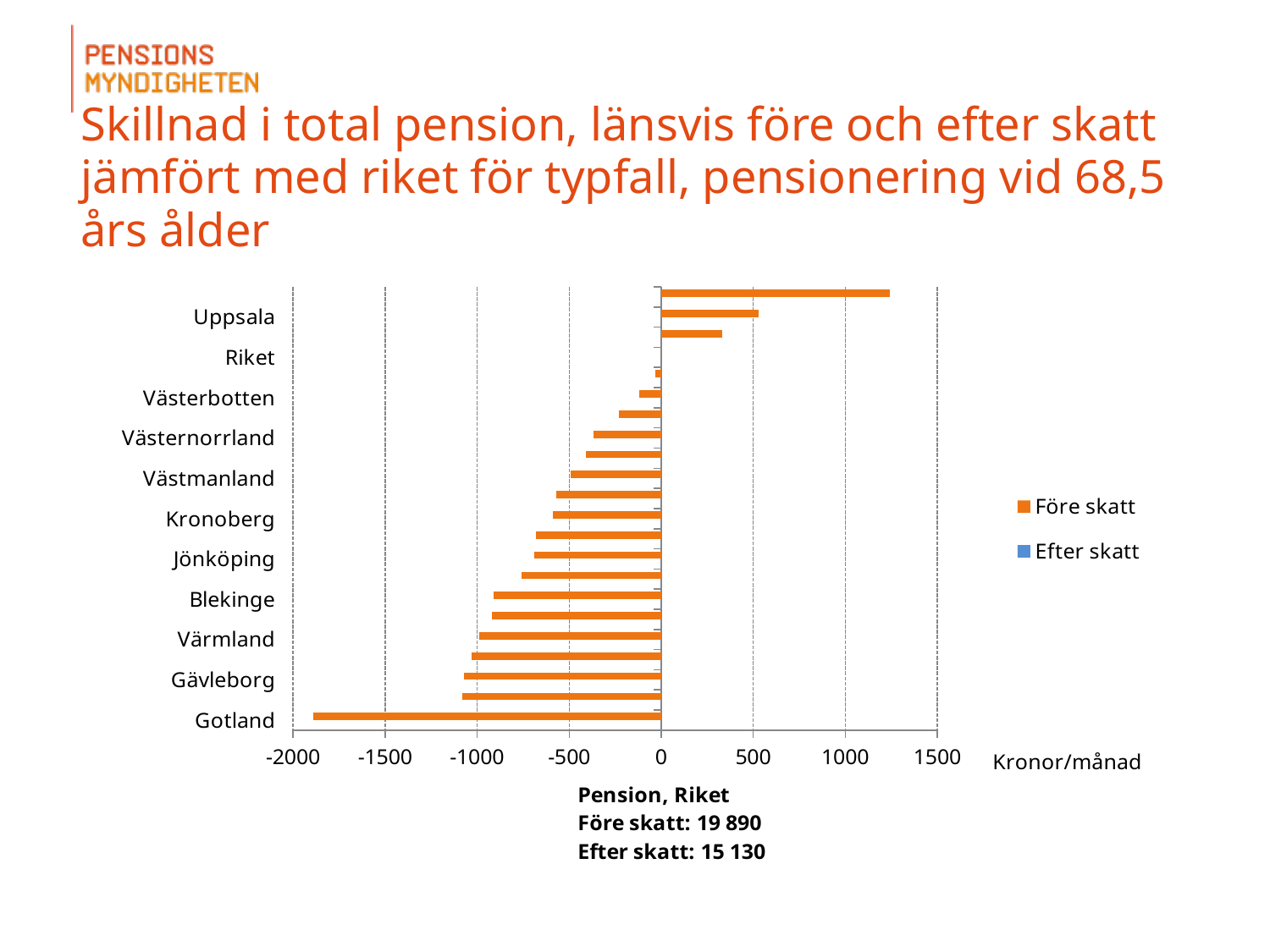
Which two series are listed in the legend? Före skatt and Efter skatt What unit is shown on the x axis of the chart? Kronor/månad Is the value for Västerbotten greater or less than -500? greater Is the value for Uppsala greater or less than 0? greater Is the value for Gotland greater or less than -1500? less Which has the larger value, Uppsala or Gotland? Uppsala How many series does the legend list? 2 What kind of chart is shown on the slide? bar chart Do the values rise or fall going down the list from Uppsala to Gotland? fall Which labelled county has the lowest value in the chart? Gotland